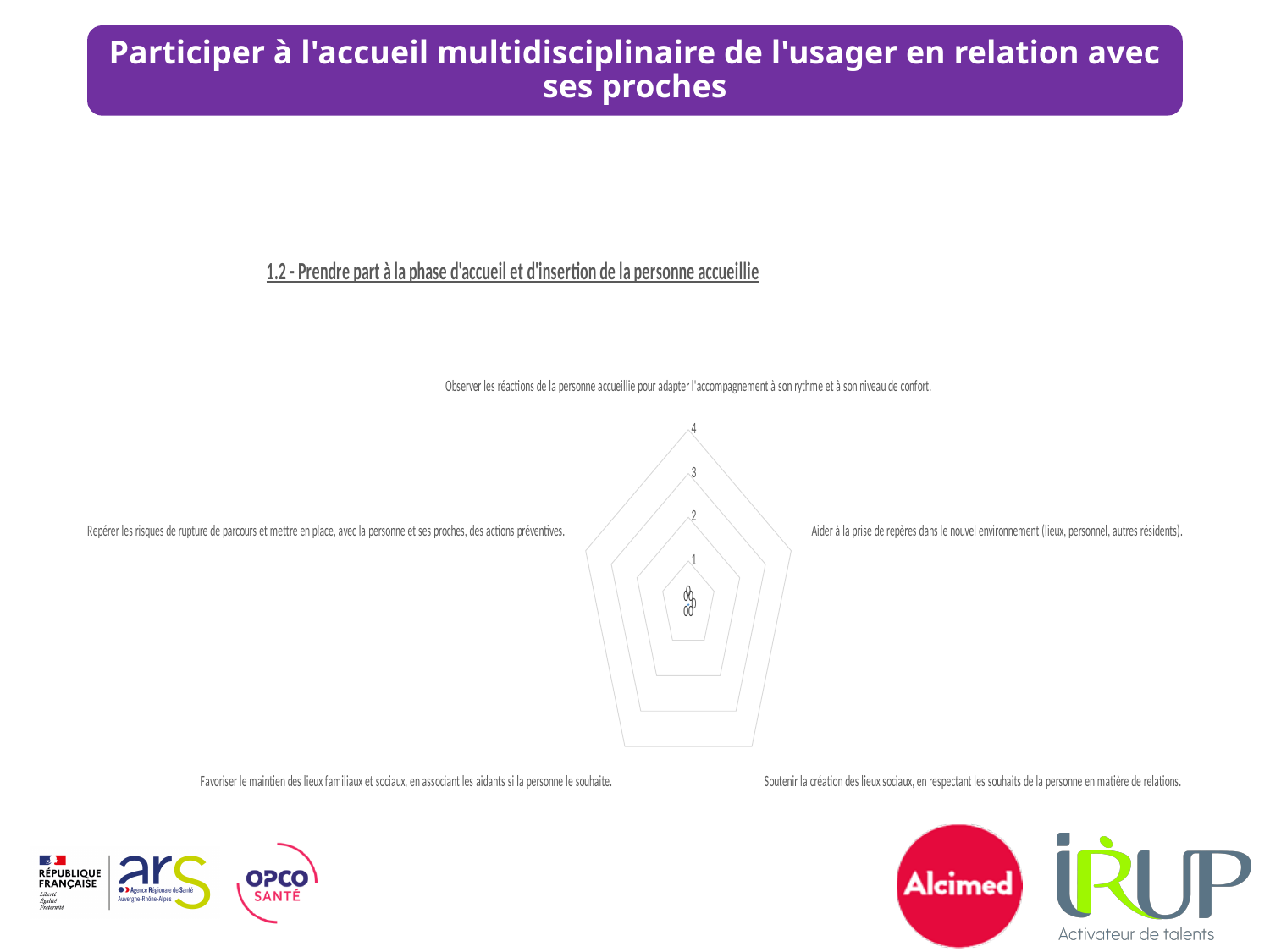
Is the value for 'Soutenir la création des lieux sociaux, en respectant les souhaits de la personne en matière de relations.' greater or less than 1? less What is the highest tick value shown on the radar chart's axis? 4 Is the value for 'Repérer les risques de rupture de parcours et mettre en place, avec la personne et ses proches, des actions préventives.' greater or less than 1? less What value is plotted for 'Observer les réactions de la personne accueillie pour adapter l'accompagnement à son rythme et à son niveau de confort.'? 0 What value is plotted for 'Aider à la prise de repères dans le nouvel environnement (lieux, personnel, autres résidents).'? 0 How many categories (axes) does the radar chart have? 5 Which category label appears at the top of the radar chart? Observer les réactions de la personne accueillie pour adapter l'accompagnement à son rythme et à son niveau de confort. What kind of chart is shown on the slide? Radar chart What is the title of the radar chart? 1.2 - Prendre part à la phase d'accueil et d'insertion de la personne accueillie Is the value for 'Favoriser le maintien des lieux familiaux et sociaux, en associant les aidants si la personne le souhaite.' greater or less than 2? less